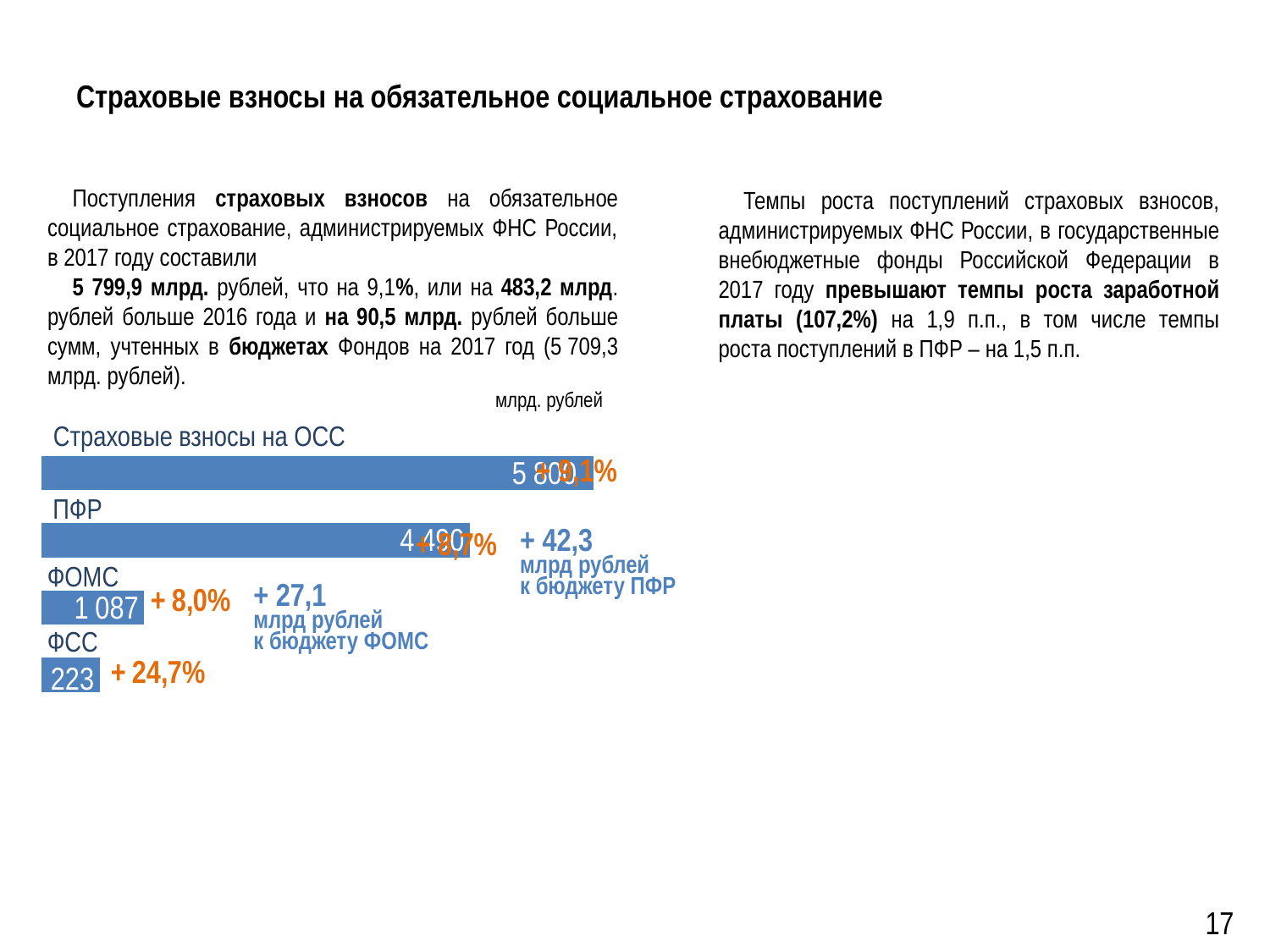
How many billion rubles above the ФОМС budget does the chart annotation show? + 27,1 What is the difference between the values for ФОМС and ФСС? 864 Which category has the largest bar? Страховые взносы на ОСС What unit is indicated above the chart? млрд. рублей How many bars (categories) does the chart show? 4 What growth percentage is shown next to the ФОМС bar? + 8,0% Which category has the smallest bar? ФСС Which is larger, the value for ФОМС or the value for ФСС? ФОМС What is the value shown for ФОМС? 1 087 What type of chart is shown on the slide? bar chart What growth percentage is shown next to the ФСС bar? + 24,7% What is the value shown for ФСС? 223